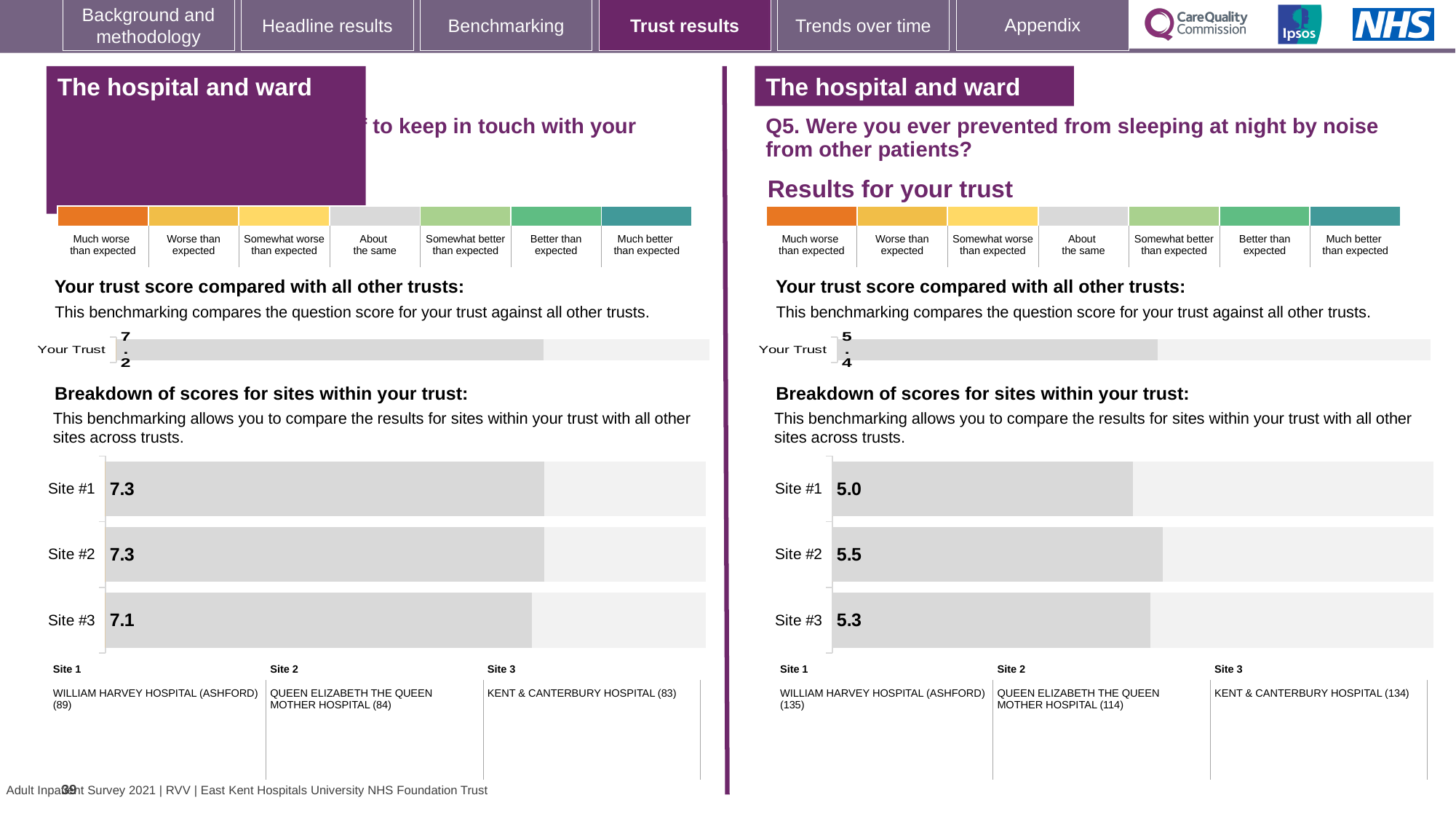
On the left-hand chart, what is the 'Your Trust' score? 7.2 On the right-hand chart for Q5, is the score for Site #3 larger or smaller than the score for Site #1? larger On the right-hand chart for Q5 (prevented from sleeping at night by noise from other patients), what is the score for Site #2? 5.5 What type of chart is used to show the breakdown of scores for sites within the trust? Bar chart On the left-hand site breakdown chart, which site has the lowest score? Site #3 On the right-hand chart for Q5, what is the score for Site #1? 5.0 On the right-hand chart for Q5, which site has the lowest score? Site #1 On the right-hand chart for Q5, what is the 'Your Trust' score? 5.4 On the right-hand chart for Q5, which site has the highest score? Site #2 On the left-hand site breakdown chart, what is the score for Site #3? 7.1 On the left-hand site breakdown chart, how many sites are shown? 3 On the right-hand chart for Q5, what is the difference between the scores for Site #2 and Site #1? 0.5